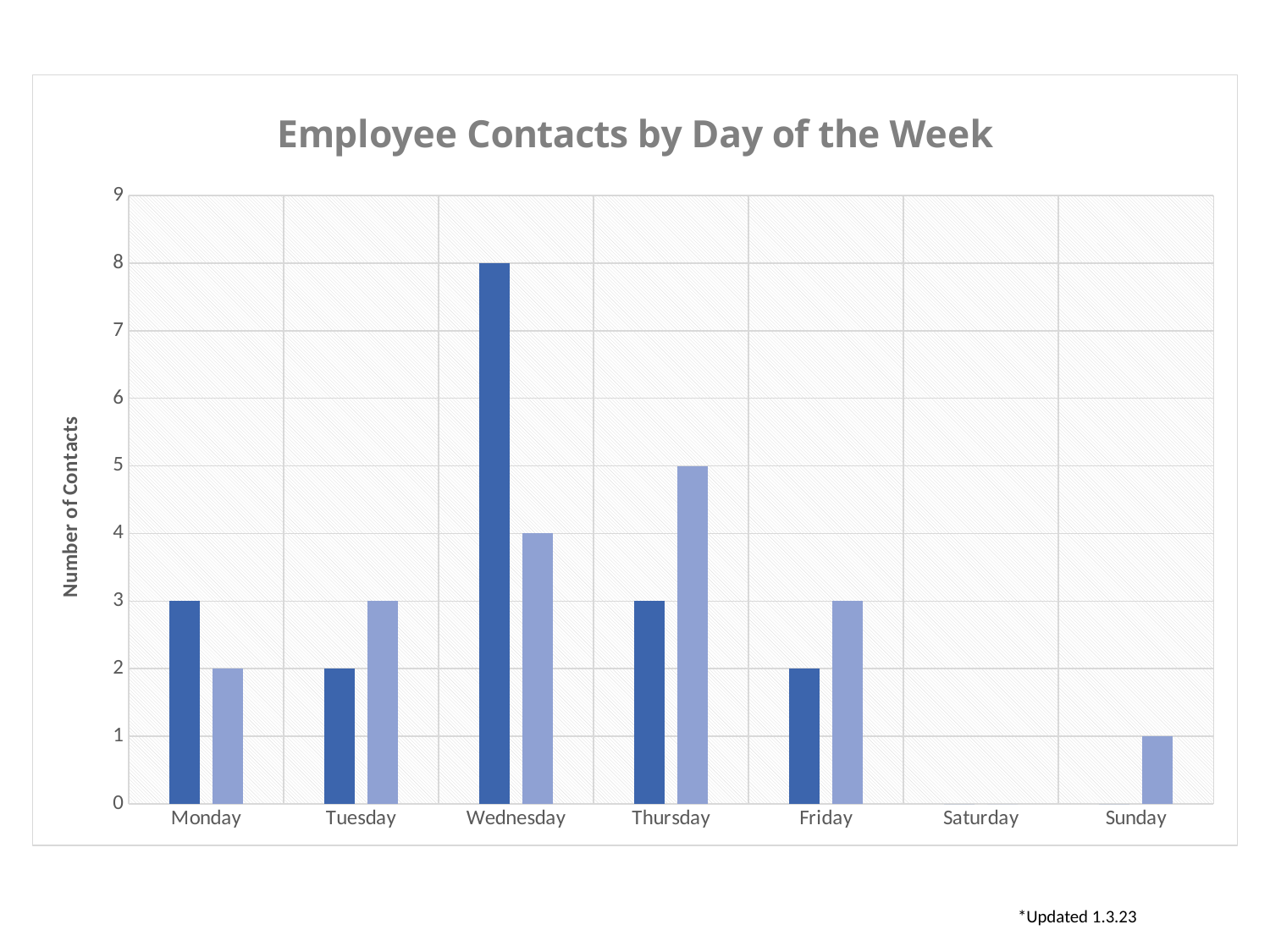
What is the value of the dark blue bar for Wednesday? 8 Is the value of the dark blue bar for Wednesday greater or less than 7? greater How many days of the week are shown on the x axis? 7 Which day has the highest light blue bar? Thursday What is the value of the light blue bar for Thursday? 5 Which day has the highest dark blue bar? Wednesday What is the label of the y axis? Number of Contacts What type of chart is shown on the slide? bar chart What is the value of the light blue bar for Sunday? 1 What is the title of the chart? Employee Contacts by Day of the Week What is the difference between the dark blue and light blue bars for Wednesday? 4 Which is larger for Monday, the dark blue bar or the light blue bar? the dark blue bar